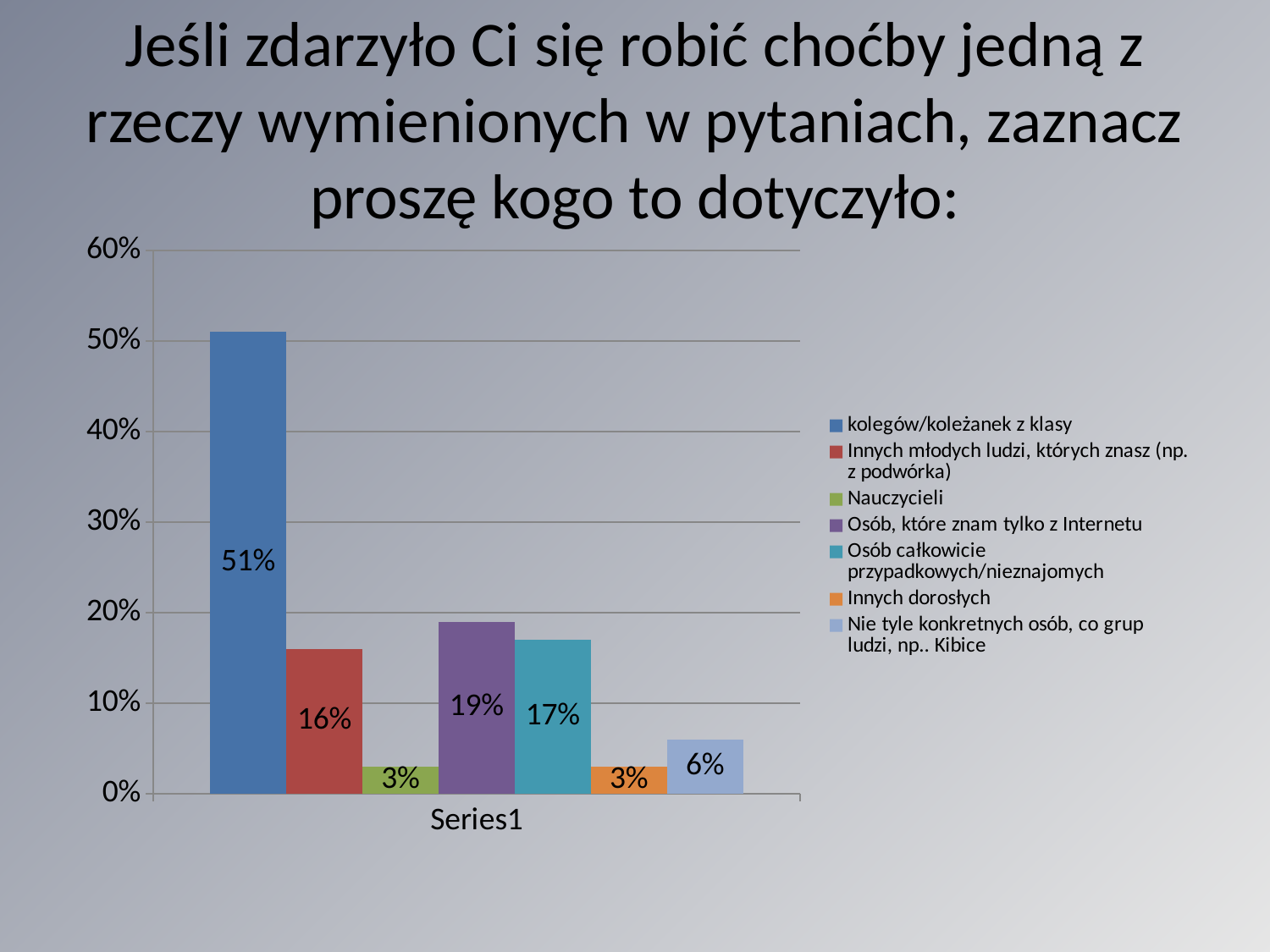
What is the difference between the values for kolegów/koleżanek z klasy and Osób, które znam tylko z Internetu? 32% What is the difference between the values for Osób, które znam tylko z Internetu and Osób całkowicie przypadkowych/nieznajomych? 2% What kind of chart is shown on the slide? bar chart What is the value for Osób, które znam tylko z Internetu? 19% What is the label shown on the x axis below the bars? Series1 What is the value for Innych młodych ludzi, których znasz (np. z podwórka)? 16% Which is larger, the value for Innych dorosłych or the value for Nie tyle konkretnych osób, co grup ludzi, np.. Kibice? Nie tyle konkretnych osób, co grup ludzi, np.. Kibice How many series does the legend list? 7 What is the value for kolegów/koleżanek z klasy? 51% Which category has the highest value? kolegów/koleżanek z klasy What is the value for Nie tyle konkretnych osób, co grup ludzi, np.. Kibice? 6% Is the value for kolegów/koleżanek z klasy greater or less than 50%? greater